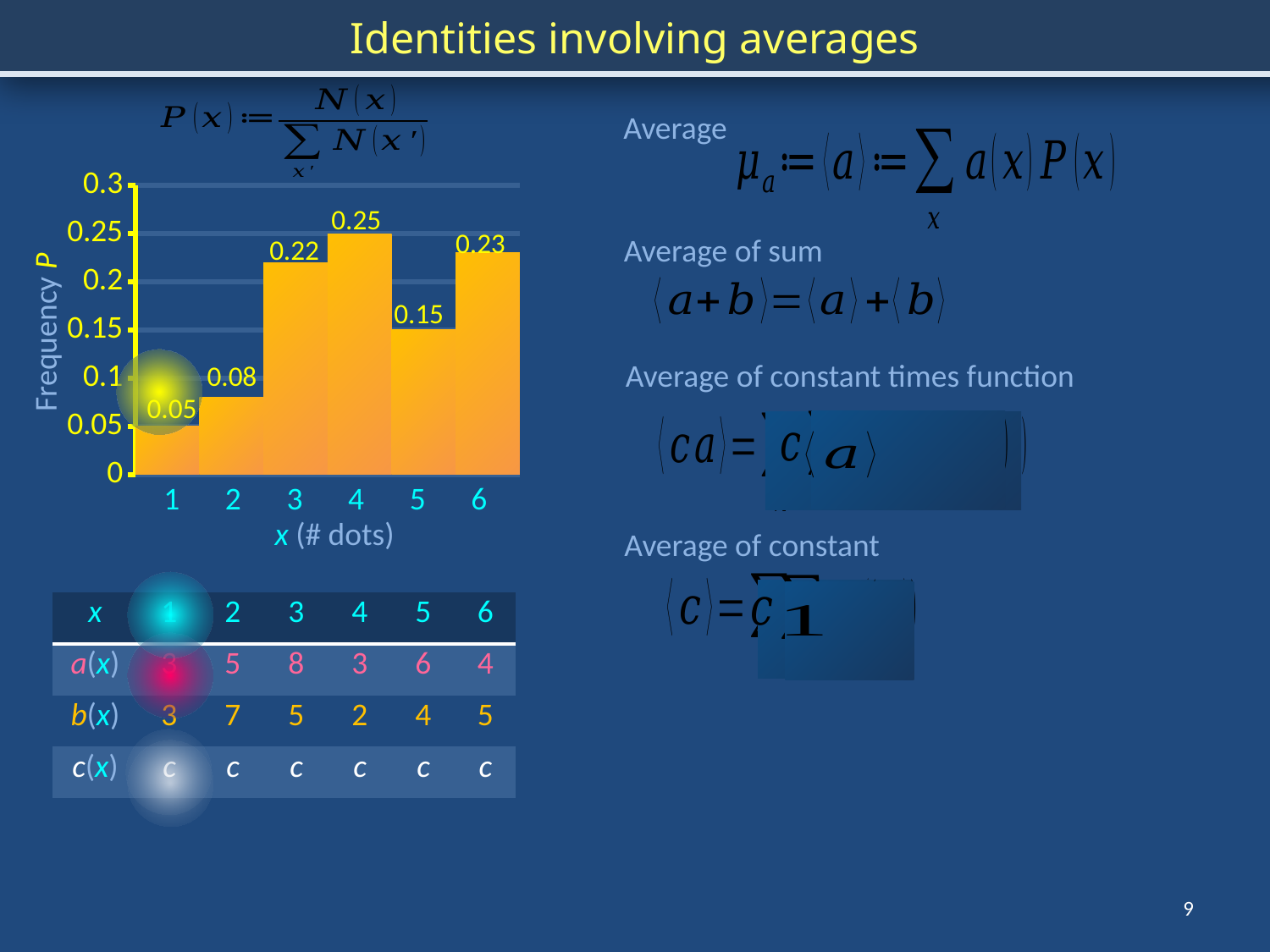
Which value of x has the lowest frequency P? 1 Is the frequency P for x = 5 greater or less than 0.2? less What is the frequency P for x = 6? 0.23 What kind of chart is shown on the slide? bar chart Which value of x has the highest frequency P? 4 What is the label of the vertical axis of the chart? Frequency P What is the frequency P for x = 1? 0.05 How many x categories are plotted in the chart? 6 What is the difference between the frequency P at x = 3 and at x = 2? 0.14 What is the difference between the frequency P at x = 4 and at x = 5? 0.1 Which has a larger frequency P, x = 3 or x = 6? x = 6 What is the frequency P for x = 4? 0.25